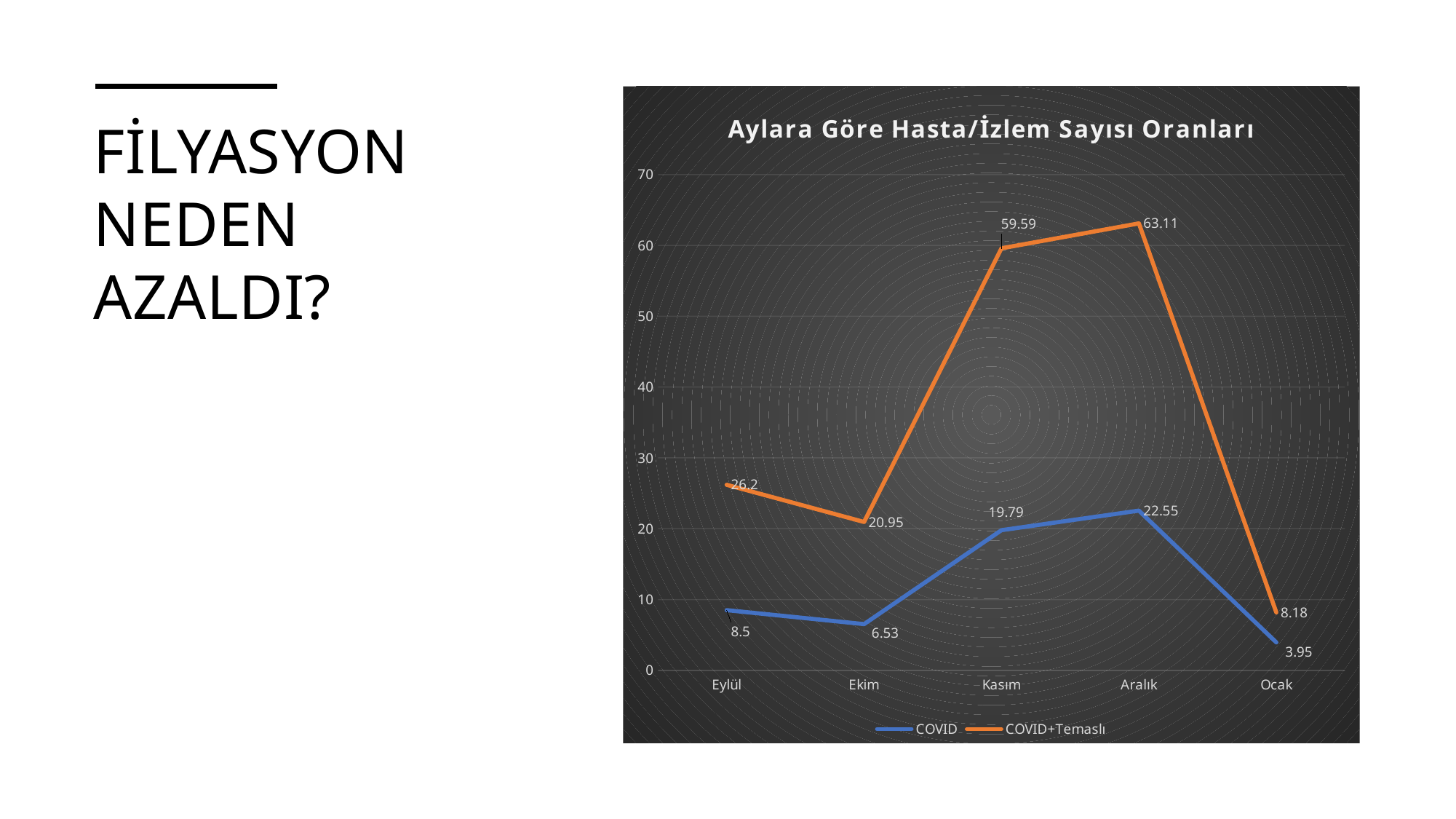
How many series does the legend list? 2 In which month is the COVID+Temaslı series lowest? Ocak Does the COVID series rise or fall from Aralık to Ocak? Fall What kind of chart is shown? Line chart What is the value for COVID+Temaslı in Ocak? 8.18 What is the difference between COVID+Temaslı and COVID in Kasım? 39.8 In which month is the COVID series highest? Aralık What is the value for COVID in Ekim? 6.53 What is the value for COVID+Temaslı in Aralık? 63.11 Which is larger in Eylül: COVID or COVID+Temaslı? COVID+Temaslı How many months are shown on the x axis? 5 What is the title of the chart? Aylara Göre Hasta/İzlem Sayısı Oranları